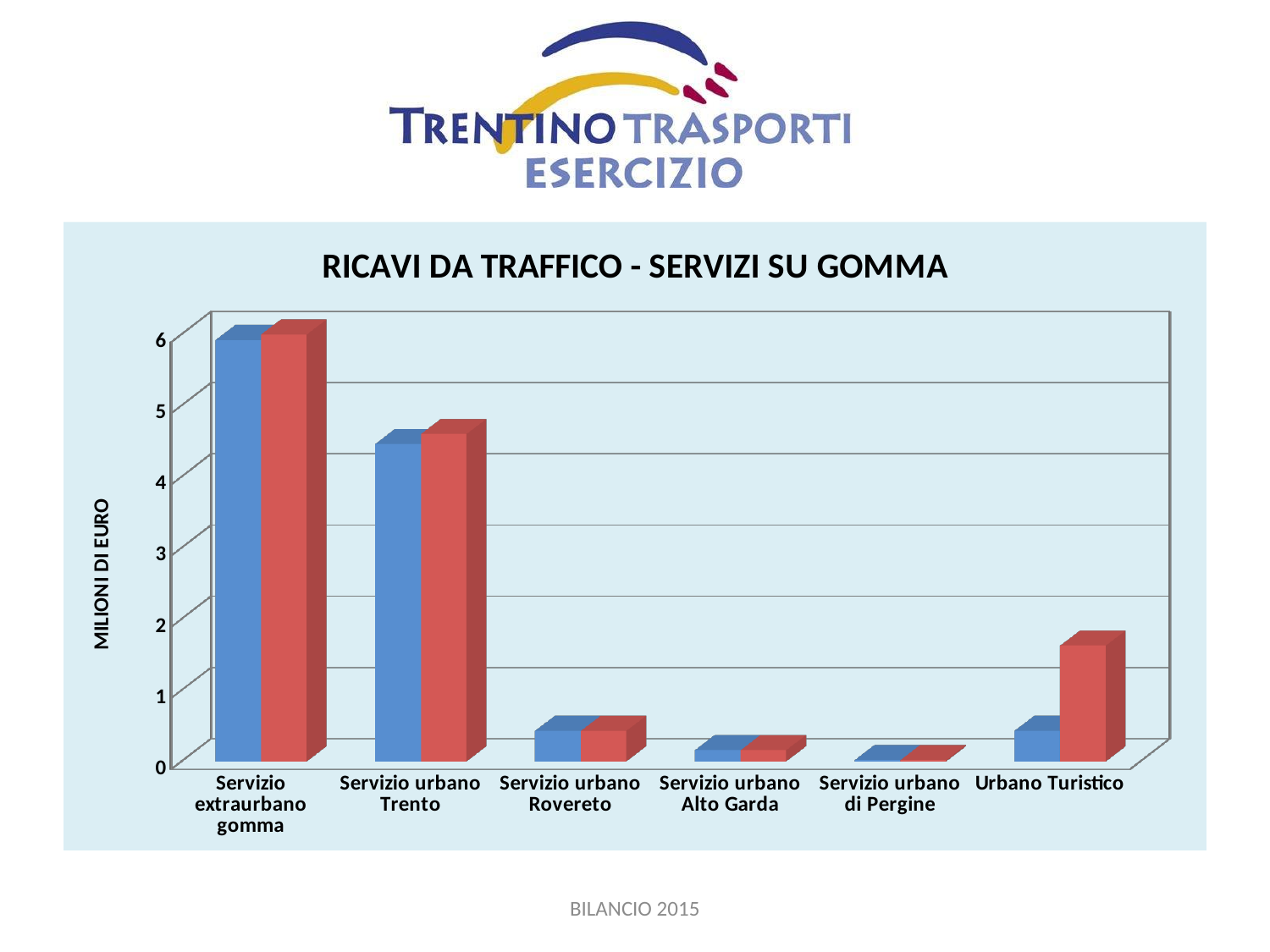
How many categories are shown on the x axis of the chart? 6 For Urbano Turistico, which bar is larger, the blue one or the red one? the red one How many bars are shown for each category in the chart? 2 Is the red bar for Urbano Turistico greater or less than 1? greater What is the label on the vertical axis of the chart? MILIONI DI EURO Are the values for Servizio extraurbano gomma greater or less than 5? greater Are the values for Servizio urbano Trento greater or less than 4? greater Which category has the highest values in the chart? Servizio extraurbano gomma What is the title of the chart? RICAVI DA TRAFFICO - SERVIZI SU GOMMA Which category has the lowest values in the chart? Servizio urbano di Pergine What type of chart is shown on the slide? bar chart